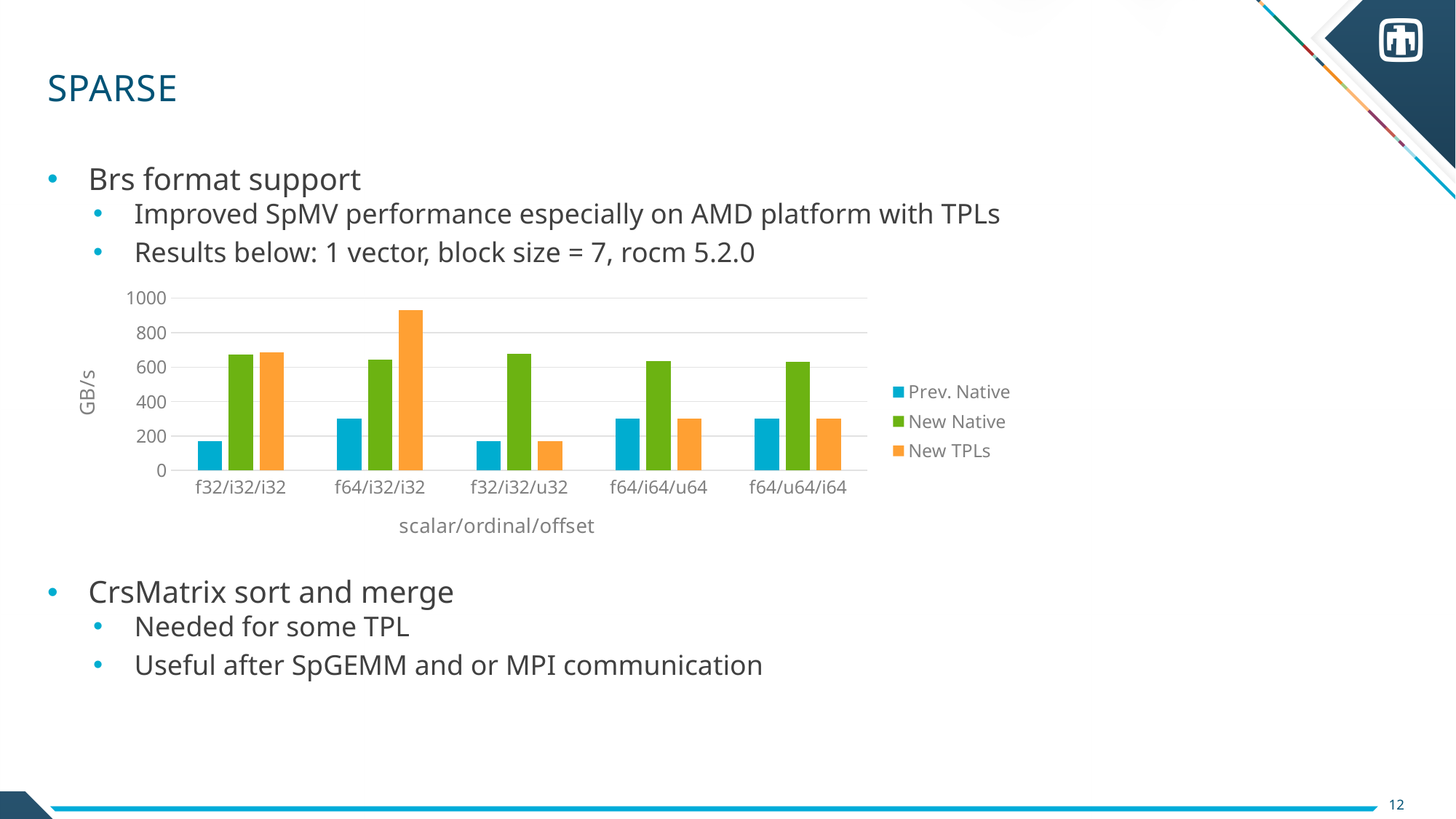
Is the New Native value for f64/u64/i64 greater or less than 600? greater Is the New TPLs value for f64/i32/i32 greater or less than 800? greater How many series does the chart's legend list? 3 What is the label on the y axis of the chart? GB/s What kind of chart is shown on the slide? Bar chart What is the label on the x axis of the chart? scalar/ordinal/offset Is the Prev. Native value for f32/i32/i32 greater or less than 200? less Which series has the lowest value for f64/i32/i32? Prev. Native Which category has the highest New TPLs value? f64/i32/i32 How many scalar/ordinal/offset categories are shown on the x axis of the chart? 5 For f64/i32/i32, which is larger: New TPLs or New Native? New TPLs For f32/i32/u32, which is larger: New Native or New TPLs? New Native